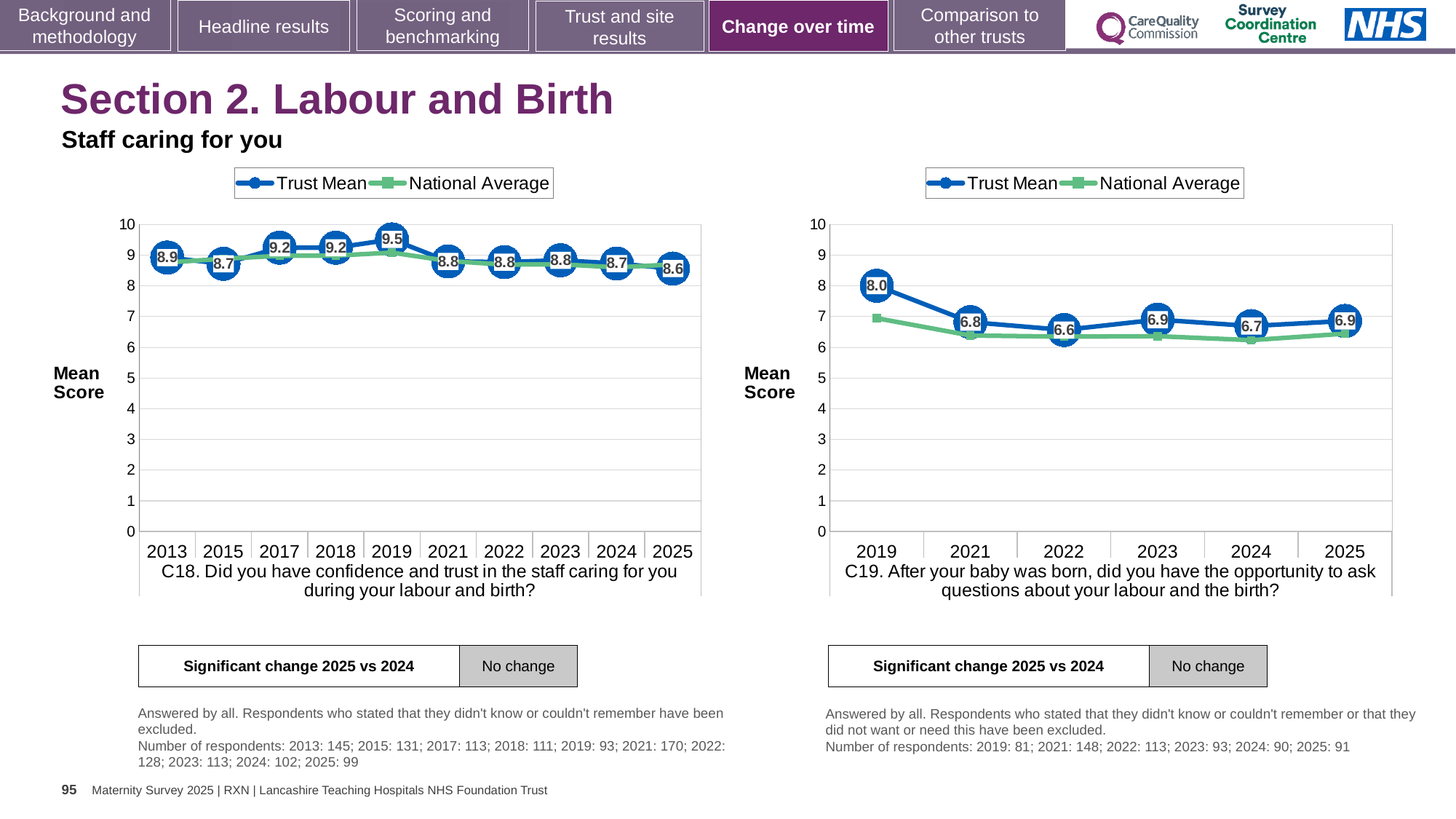
In the C18 chart (left), how many years are plotted on the x axis? 10 In the C19 chart (right), which year has the lowest Trust Mean score? 2022 In the C18 chart (left), which year has the highest Trust Mean score? 2019 In the C19 chart (right), what is the difference between the Trust Mean scores for 2019 and 2021? 1.2 In the C18 chart (left), what is the Trust Mean score for 2025? 8.6 In the C18 chart (left), what is the Trust Mean score for 2019? 9.5 In the C18 chart (left), which year has the lowest Trust Mean score? 2025 What kind of chart is the C19 chart (right)? Line chart In the C19 chart (right), is the Trust Mean score for 2019 greater or less than the Trust Mean score for 2025? greater In the C19 chart (right), how many series does the legend list? 2 In the C18 chart (left), what is the difference between the Trust Mean scores for 2019 and 2025? 0.9 In the C19 chart (right), what is the Trust Mean score for 2019? 8.0